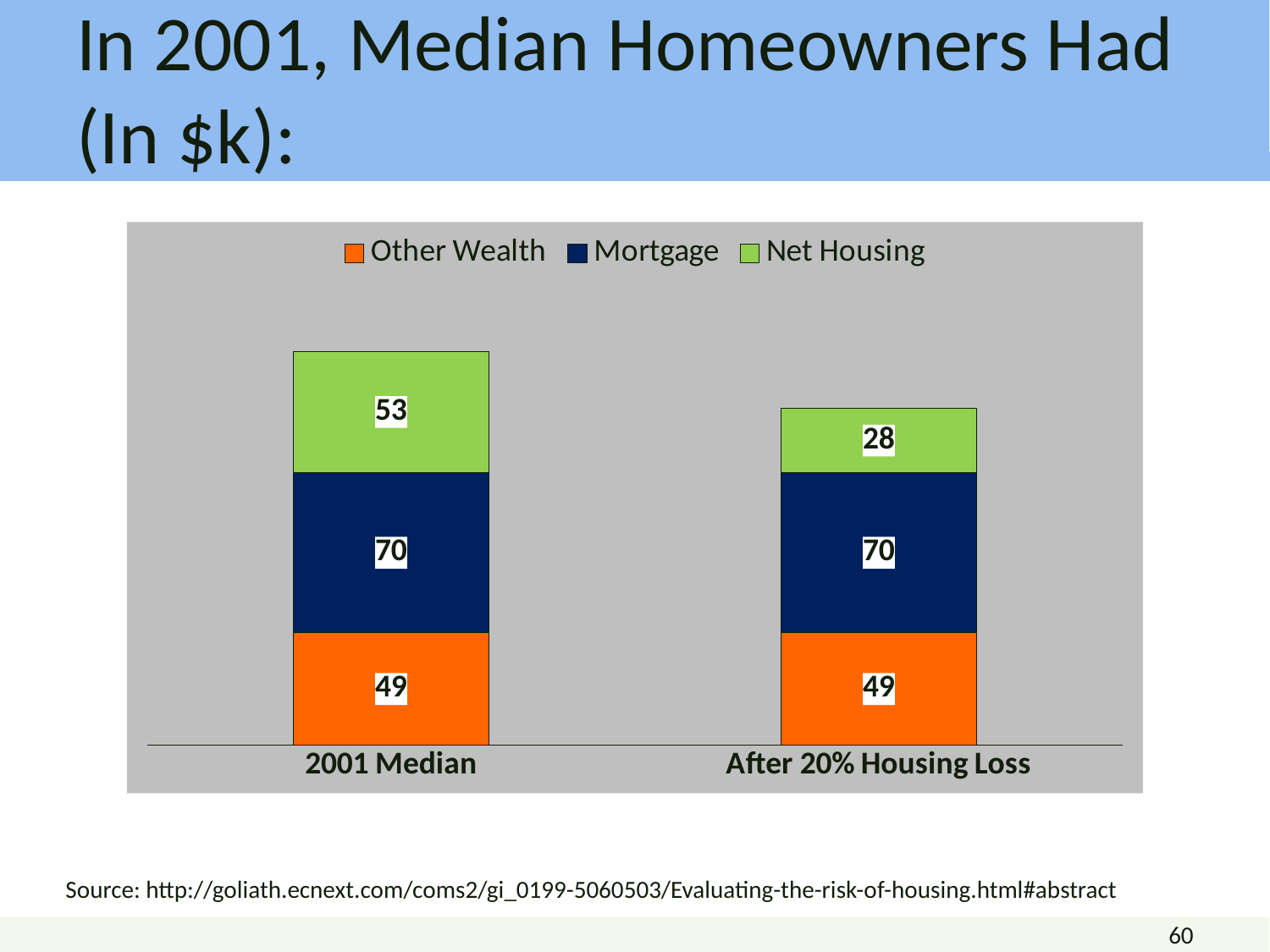
What is the difference between the Net Housing values for 2001 Median and After 20% Housing Loss? 25 Which series has the largest value in the 2001 Median bar? Mortgage What kind of chart is shown on the slide? Stacked bar chart What is the total of the stacked bar for 2001 Median? 172 What is the Net Housing value for 2001 Median? 53 What is the Net Housing value for After 20% Housing Loss? 28 What is the Mortgage value for After 20% Housing Loss? 70 How many categories are shown on the x axis? 2 How many series does the legend list? 3 Which category has the higher Net Housing value, 2001 Median or After 20% Housing Loss? 2001 Median What is the total of the stacked bar for After 20% Housing Loss? 147 What is the Other Wealth value for 2001 Median? 49